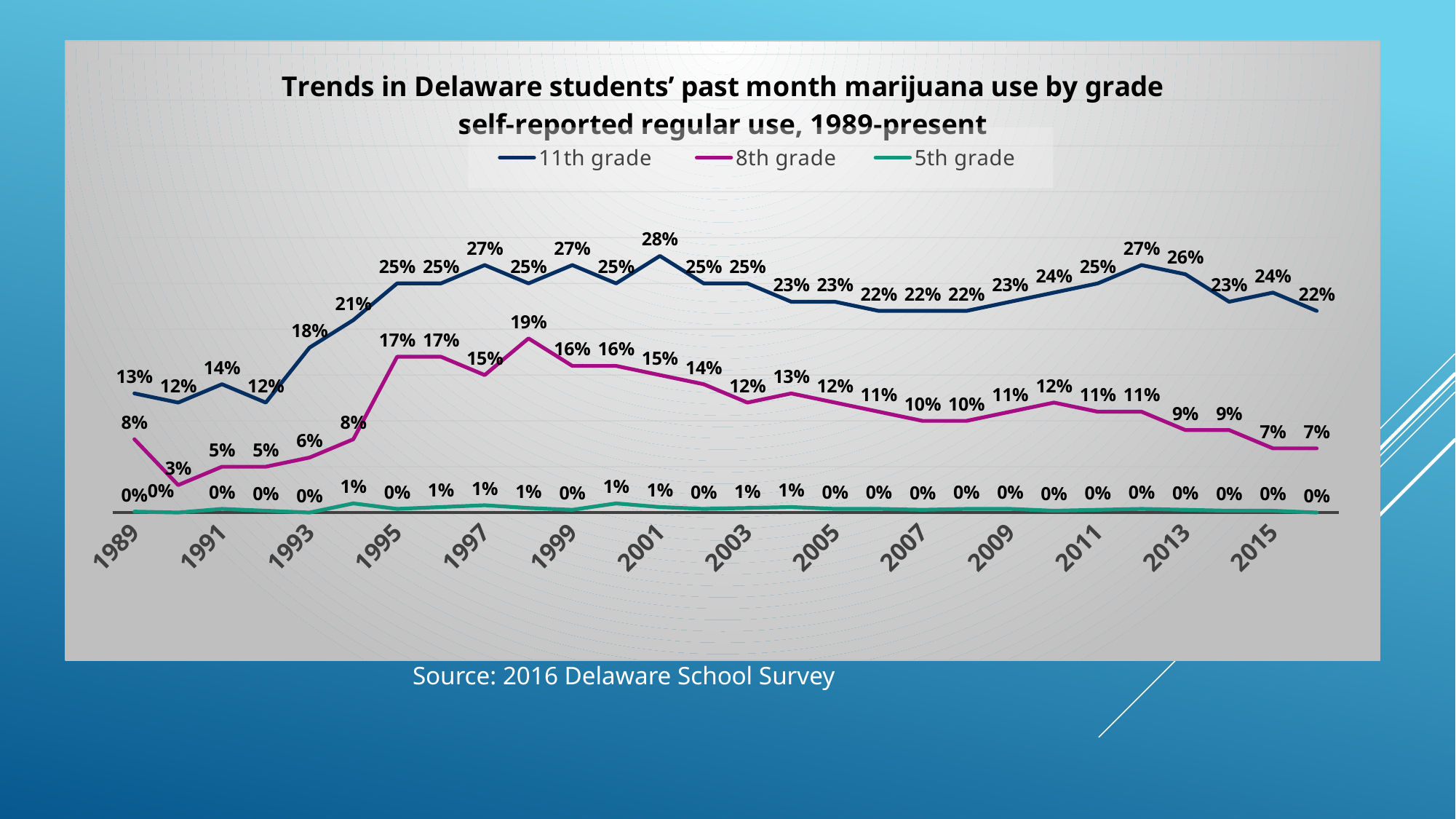
In which year did the 11th grade series reach its highest value? 2001 How many series does the legend list? 3 What was the 11th grade value in 2001? 28% What was the 8th grade value in 1989? 8% What kind of chart is shown on the slide? Line chart Which was higher in 1995, the 11th grade value or the 8th grade value? 11th grade Did the 8th grade values rise or fall from 2012 to 2016? Fall What was the 8th grade value in 1998? 19% What source is cited below the chart? 2016 Delaware School Survey In which year did the 8th grade series reach its highest value? 1998 In which year was the 8th grade value lowest? 1990 What is the difference between the 11th grade and 8th grade values in 2016? 15 percentage points